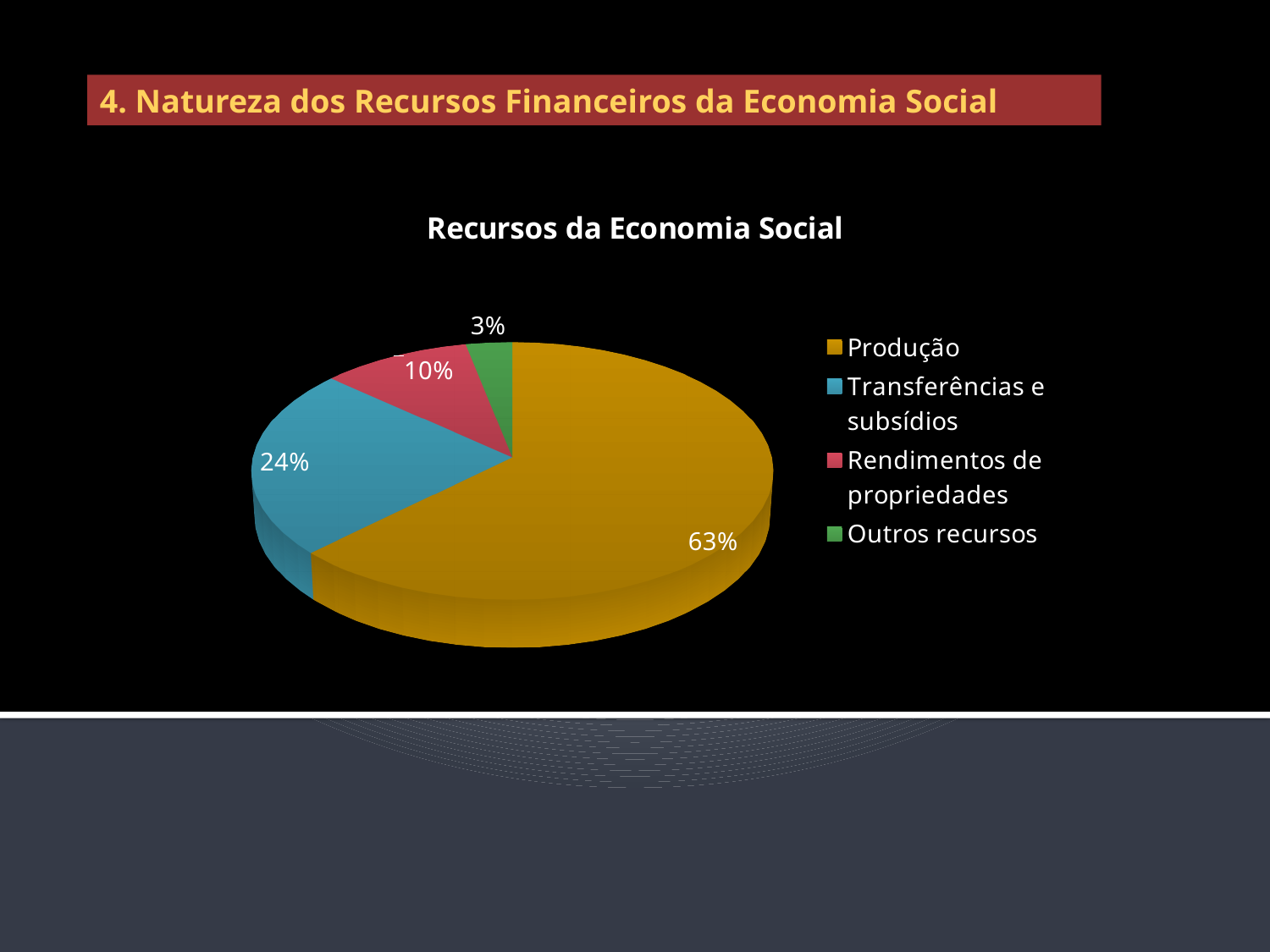
Which is larger, the share for Rendimentos de propriedades or the share for Outros recursos? Rendimentos de propriedades What is the difference in percentage points between Produção and Transferências e subsídios? 39 What share of the pie does Produção represent? 63% What share of the pie does Rendimentos de propriedades represent? 10% Which category has the largest slice of the pie? Produção Which category has the smallest slice of the pie? Outros recursos How many categories does the legend list? 4 What kind of chart is shown on the slide? Pie chart What colour is the slice for Transferências e subsídios? Blue What share of the pie does Transferências e subsídios represent? 24% What is the title of the chart? Recursos da Economia Social